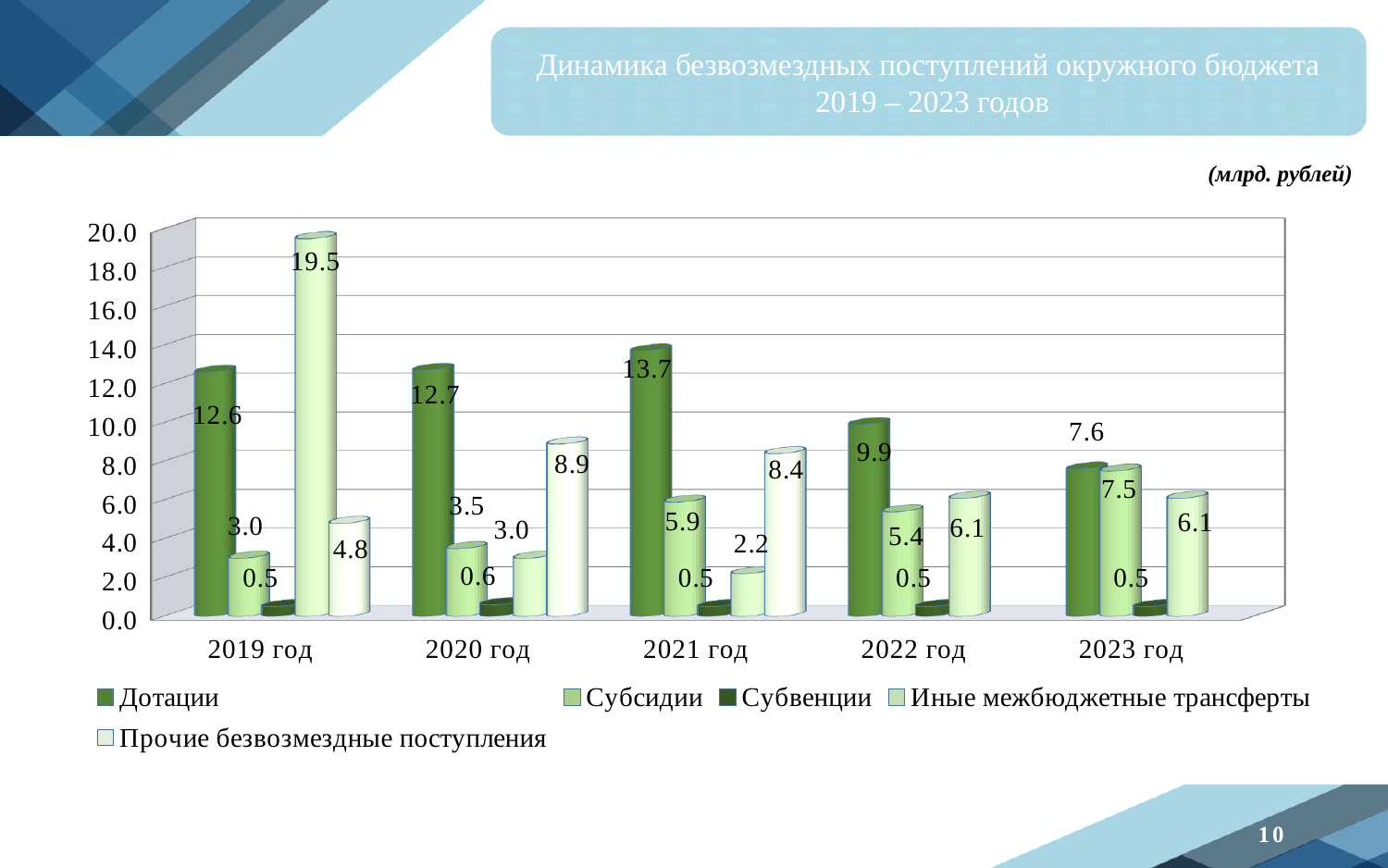
What kind of chart is shown on the slide? bar chart How many series does the legend list? 5 What is the value for Прочие безвозмездные поступления in 2020 год? 8.9 What is the value for Дотации in 2021 год? 13.7 What is the value for Иные межбюджетные трансферты in 2019 год? 19.5 How many years are shown on the x axis? 5 Which series has the highest value in 2019 год? Иные межбюджетные трансферты In which year is the value for Дотации the highest? 2021 год What is the difference between the Дотации values for 2019 год and 2023 год? 5.0 What is the difference between the Иные межбюджетные трансферты values for 2019 год and 2020 год? 16.5 In 2020 год, which is larger: Прочие безвозмездные поступления or Иные межбюджетные трансферты? Прочие безвозмездные поступления In which year is the value for Дотации the lowest? 2023 год